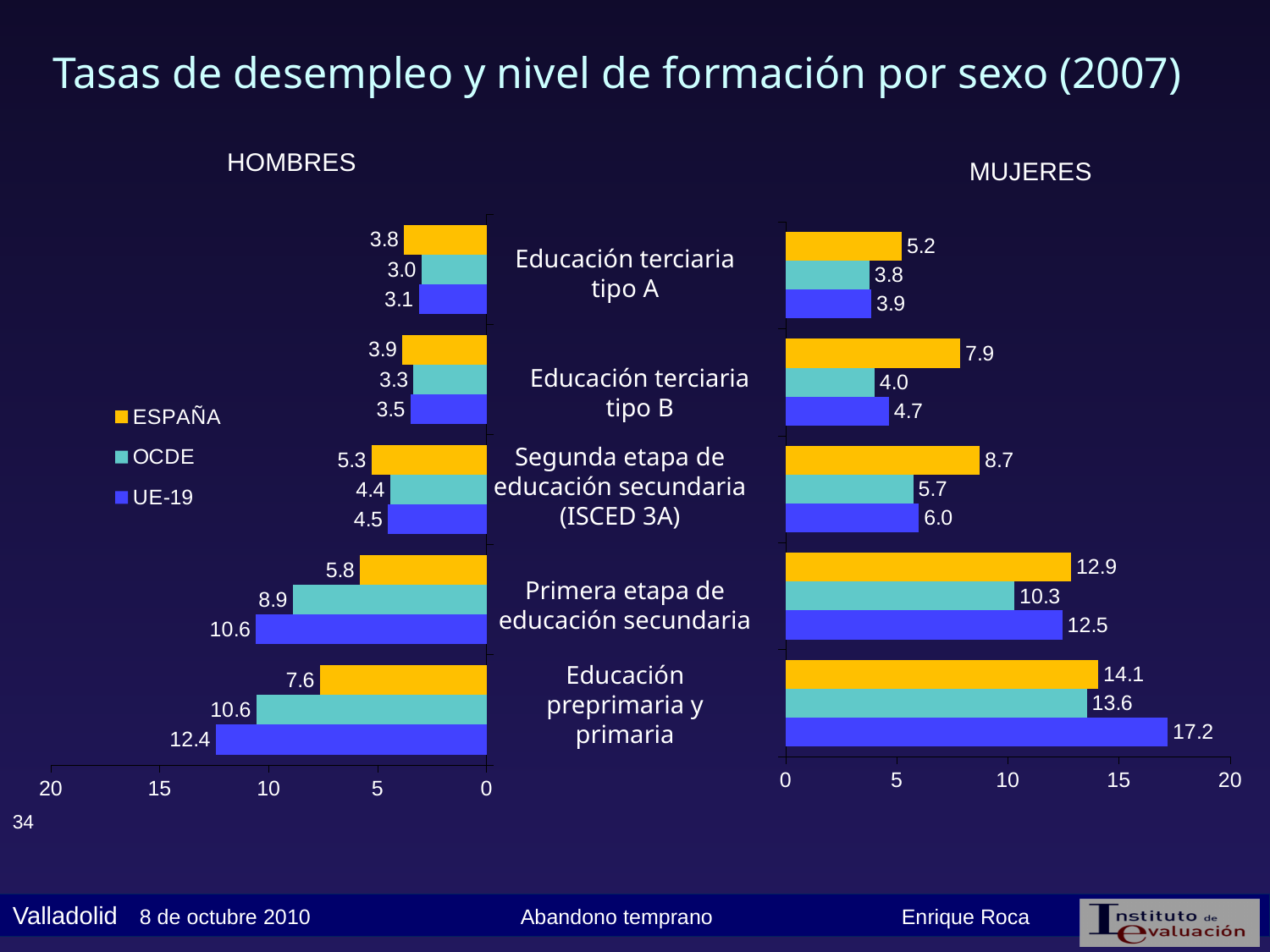
How many series does the legend list? 3 In the MUJERES chart, is the value for ESPAÑA in Educación terciaria tipo B greater or less than 5? greater Which series is shown in yellow in the legend? ESPAÑA In the MUJERES chart, what is the value for OCDE in Primera etapa de educación secundaria? 10.3 In the HOMBRES chart, what is the value for ESPAÑA in Educación preprimaria y primaria? 7.6 In the MUJERES chart, what is the difference between the ESPAÑA and OCDE values for Segunda etapa de educación secundaria (ISCED 3A)? 3.0 How many education-level categories does the HOMBRES chart show? 5 In the HOMBRES chart, which is larger for Primera etapa de educación secundaria: the OCDE value or the UE-19 value? UE-19 In the MUJERES chart, which category has the lowest value for ESPAÑA? Educación terciaria tipo A In the MUJERES chart, what is the value for UE-19 in Educación preprimaria y primaria? 17.2 In the HOMBRES chart, which category has the highest value for UE-19? Educación preprimaria y primaria What kind of chart is the MUJERES chart? Bar chart